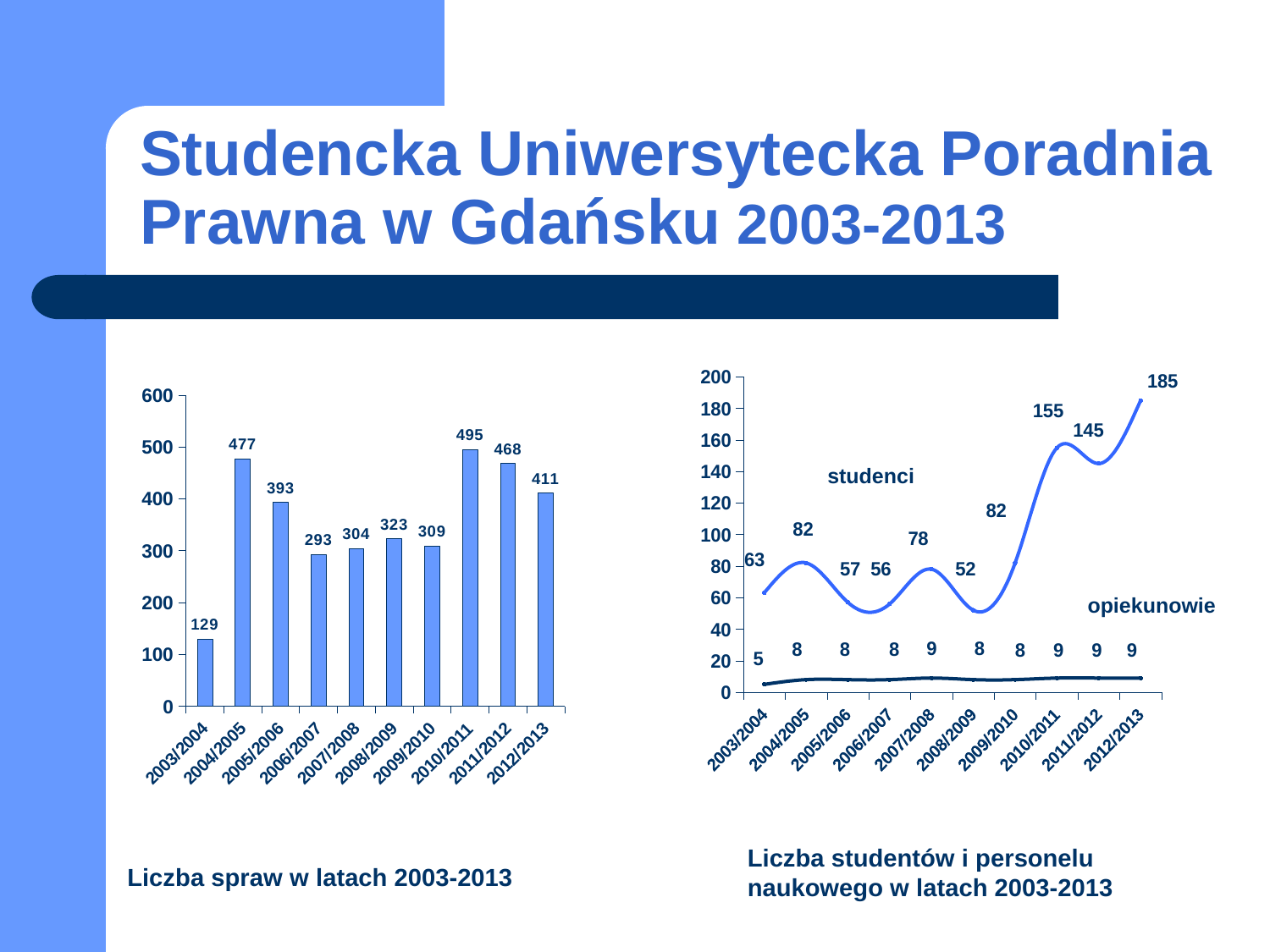
In the right chart (Liczba studentów i personelu naukowego), what is the value for opiekunowie in 2003/2004? 5 In the right chart (Liczba studentów i personelu naukowego), is the value for studenci in 2010/2011 larger than the value in 2011/2012? Yes, 2010/2011 (155) is larger In the left chart (Liczba spraw w latach 2003-2013), which year has the lowest number of cases? 2003/2004 In the left chart (Liczba spraw w latach 2003-2013), what is the value for 2004/2005? 477 What kind of chart is the left chart (Liczba spraw w latach 2003-2013)? bar chart In the right chart (Liczba studentów i personelu naukowego), how many series are plotted? 2 What kind of chart is the right chart (Liczba studentów i personelu naukowego)? line chart In the left chart (Liczba spraw w latach 2003-2013), how many years are shown on the x axis? 10 In the right chart (Liczba studentów i personelu naukowego), which year has the lowest value for studenci? 2008/2009 In the left chart (Liczba spraw w latach 2003-2013), which year has the highest number of cases? 2010/2011 In the right chart (Liczba studentów i personelu naukowego), what is the value for studenci in 2012/2013? 185 In the left chart (Liczba spraw w latach 2003-2013), what is the difference between the values for 2010/2011 and 2011/2012? 27